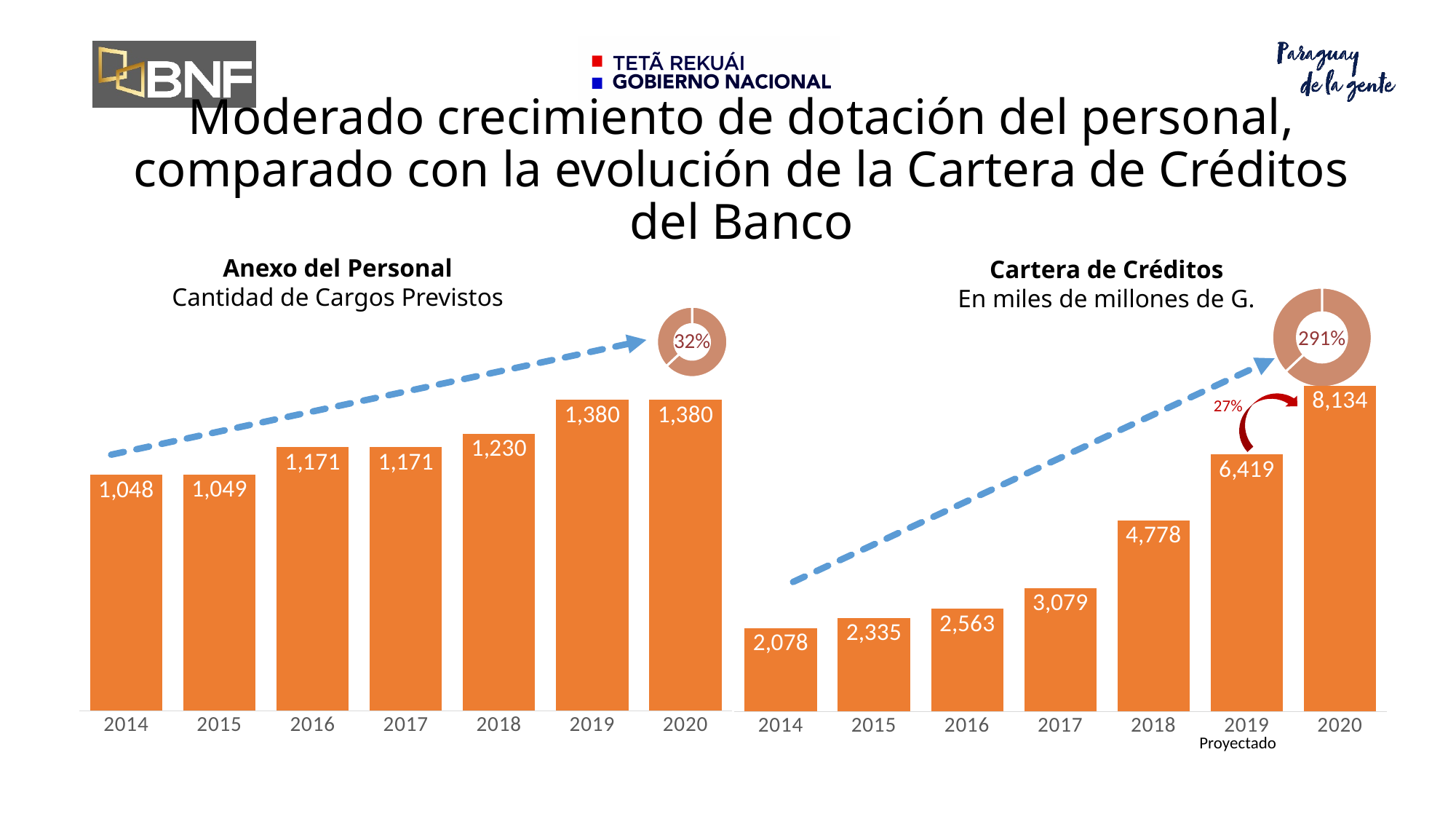
In the Cartera de Créditos chart, what is the value for 2017? 3,079 In the Anexo del Personal chart, what is the difference between the 2020 and 2014 values? 332 In the Cartera de Créditos chart, do the values rise or fall from 2014 to 2020? rise In the Cartera de Créditos chart, which is larger, the value for 2016 or the value for 2018? 2018 In the Anexo del Personal chart, which year has the lowest value? 2014 What percentage is shown in the circle above the Cartera de Créditos chart? 291% In the Cartera de Créditos chart, what is the difference between the 2020 and 2019 values? 1,715 What kind of chart is the Cartera de Créditos chart? bar chart In the Cartera de Créditos chart, what is the value for 2020? 8,134 How many years are shown in the Anexo del Personal chart? 7 In the Anexo del Personal chart, what is the value for 2018? 1,230 In the Cartera de Créditos chart, which year has the highest value? 2020